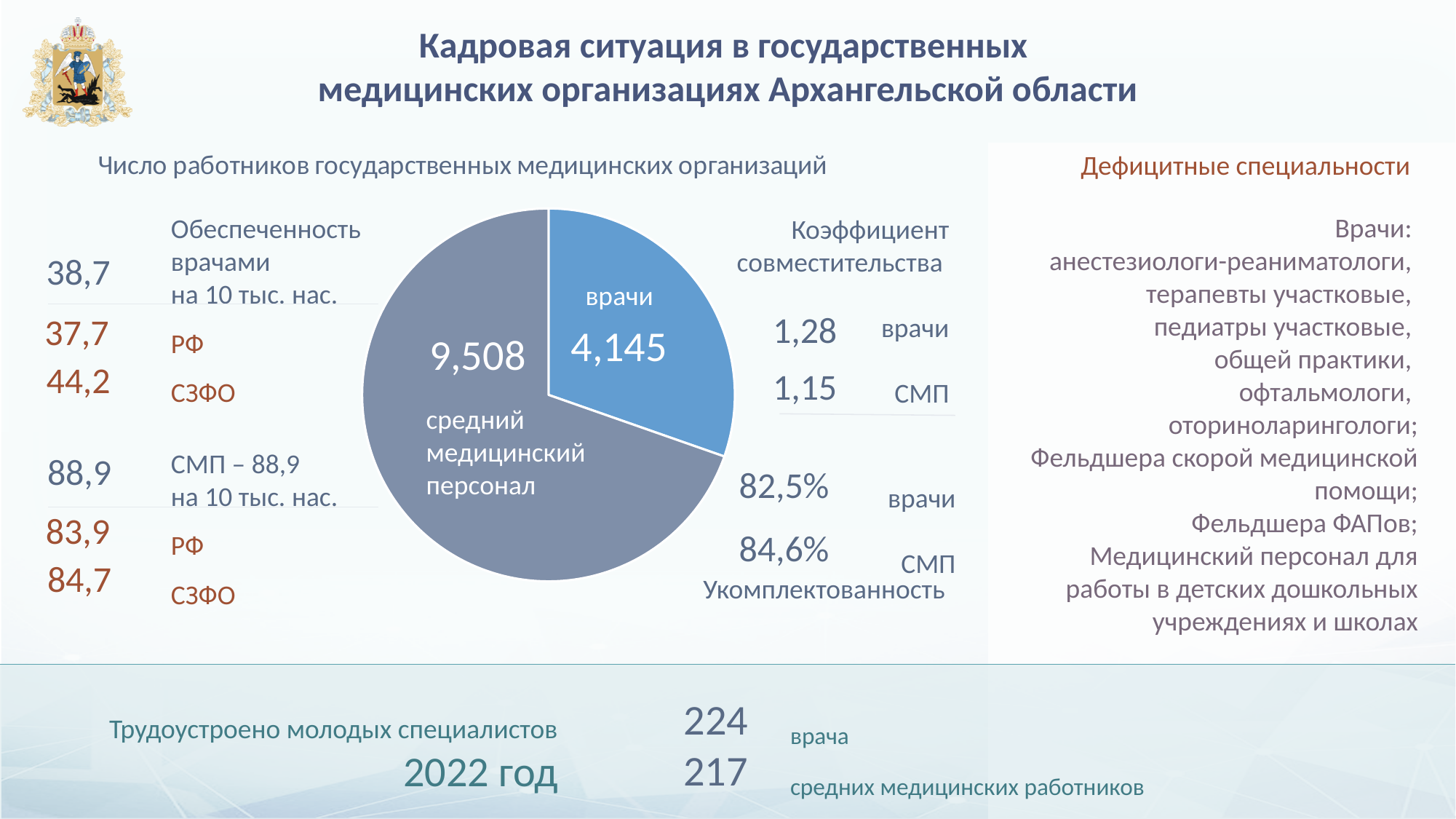
Which is larger in the pie chart: врачи or средний медицинский персонал? средний медицинский персонал Which slice of the pie chart is the smallest? врачи What colour is the "врачи" slice in the pie chart? blue How many slices does the pie chart have? 2 Which slice of the pie chart is the largest? средний медицинский персонал What is the heading above the pie chart? Число работников государственных медицинских организаций What value is shown for "средний медицинский персонал" in the pie chart? 9,508 What is the difference between the values for средний медицинский персонал and врачи in the pie chart? 5,363 What is the total of the two values shown in the pie chart? 13,653 What share of the pie chart does the "врачи" slice represent? 30,4% What value is shown for "врачи" in the pie chart? 4,145 What kind of chart is shown under the heading "Число работников государственных медицинских организаций"? pie chart